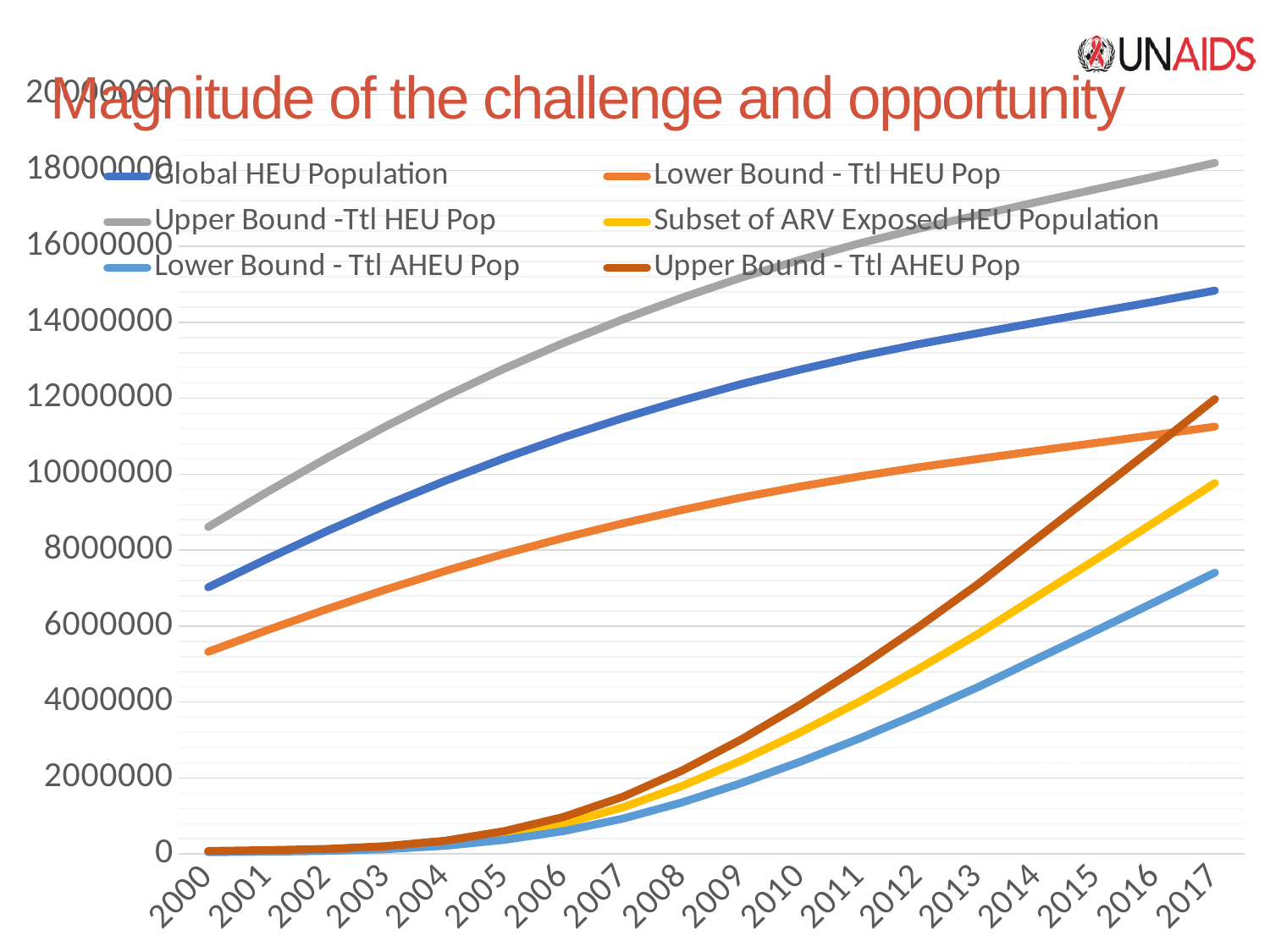
How many years are shown along the x axis? 18 Is the value for Global HEU Population in 2017 greater or less than 14000000? greater Is the value for Subset of ARV Exposed HEU Population in 2017 greater or less than 10000000? less How many series does the legend list? 6 Does the Global HEU Population series rise or fall from 2000 to 2017? rise Is the value for Lower Bound - Ttl AHEU Pop in 2017 greater or less than 8000000? less Which series has the highest value in 2017? Upper Bound -Ttl HEU Pop What kind of chart is shown on the slide? line chart Which series has the lowest value in 2017? Lower Bound - Ttl AHEU Pop In 2017, which is larger: Global HEU Population or Lower Bound - Ttl HEU Pop? Global HEU Population What is the title of the slide? Magnitude of the challenge and opportunity